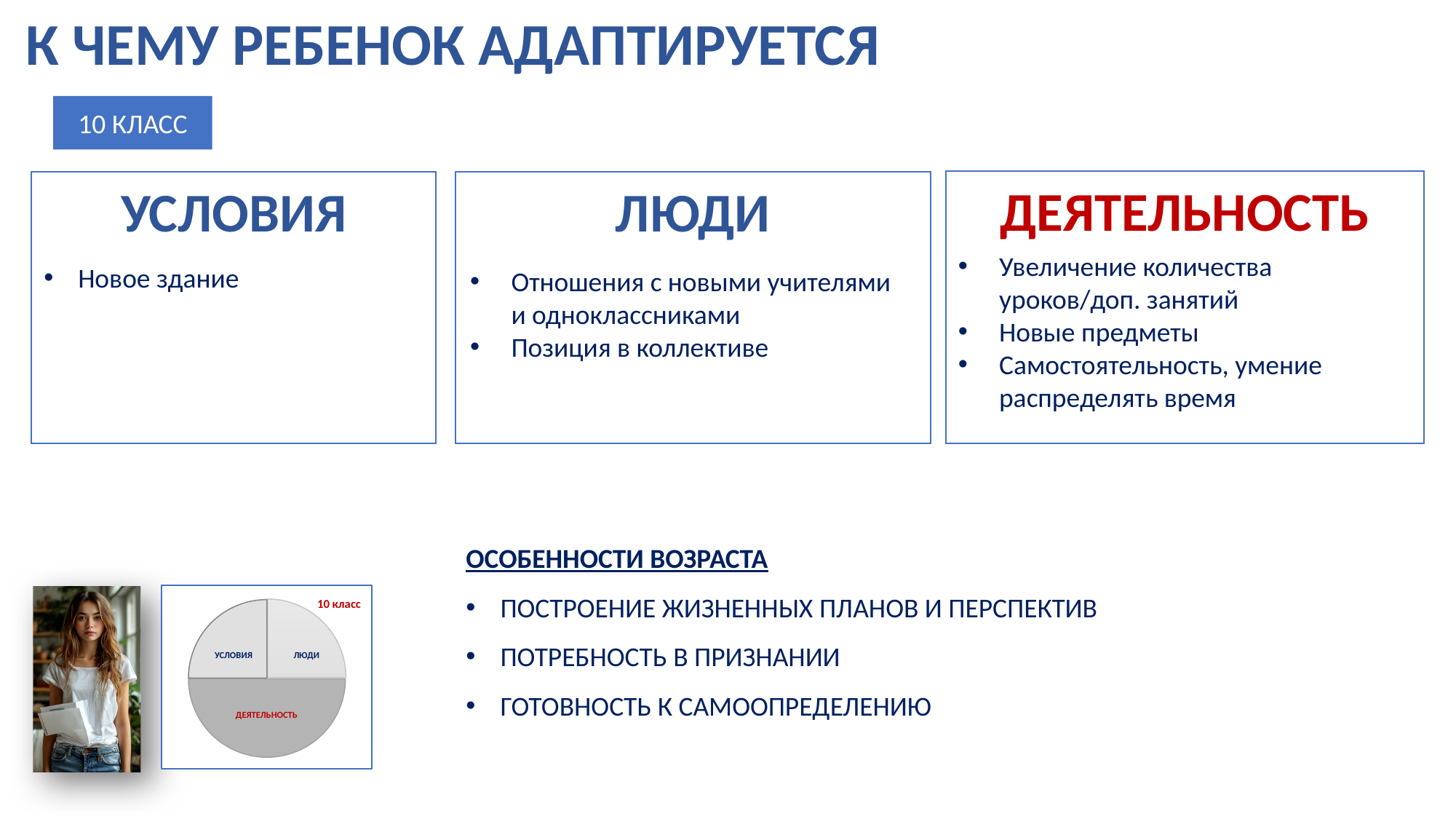
Which slice label in the pie chart is written in red? ДЕЯТЕЛЬНОСТЬ How many slices does the pie chart have? 3 What label is printed in red in the top right corner of the pie chart? 10 класс What kind of chart is shown at the bottom left of the slide? pie chart In the pie chart, which slice is larger: ДЕЯТЕЛЬНОСТЬ or ЛЮДИ? ДЕЯТЕЛЬНОСТЬ In the pie chart, which slice is larger: ДЕЯТЕЛЬНОСТЬ or УСЛОВИЯ? ДЕЯТЕЛЬНОСТЬ Which slice of the pie chart is the largest? ДЕЯТЕЛЬНОСТЬ